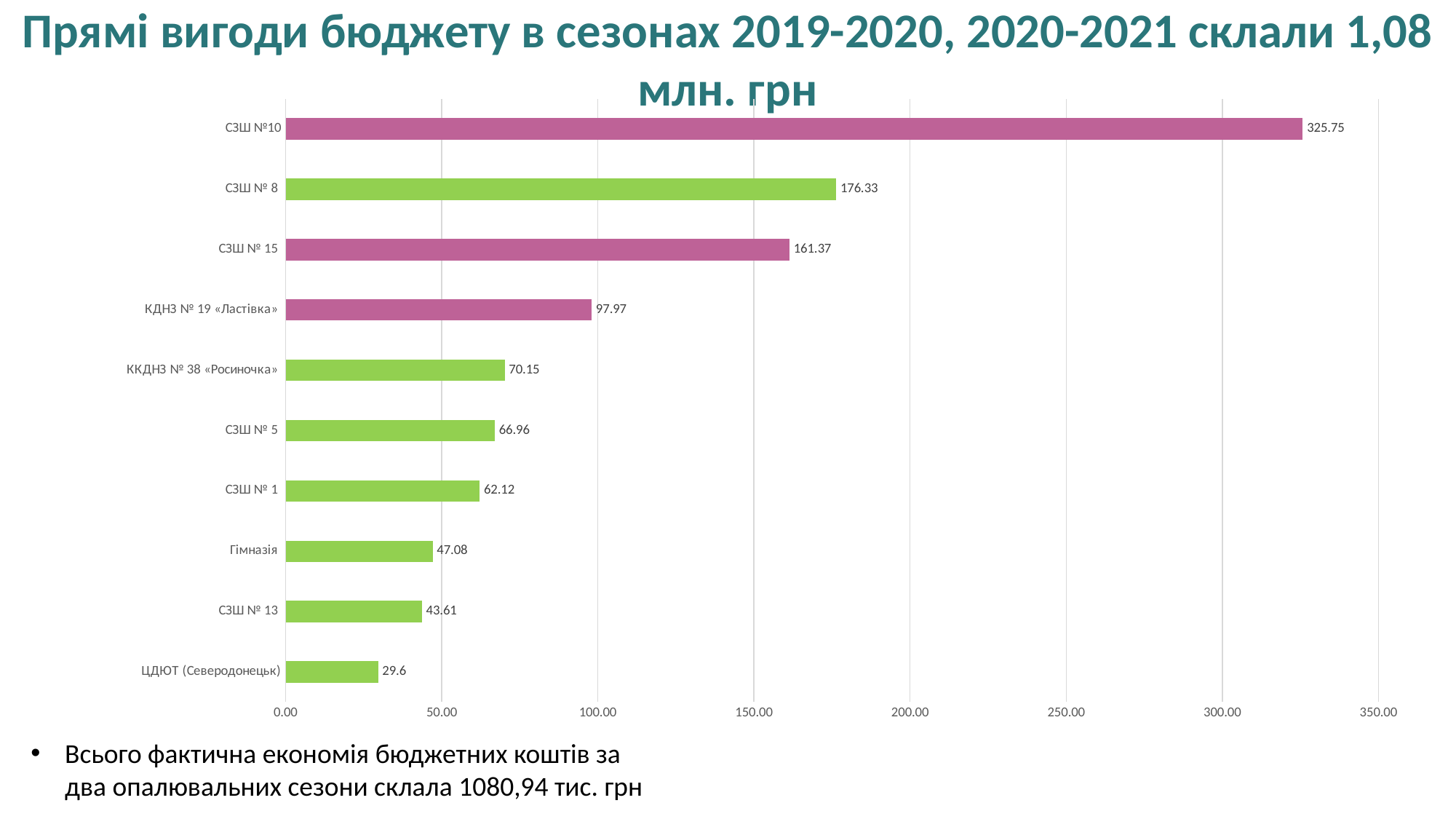
What is the difference between the values for СЗШ №10 and СЗШ № 8? 149.42 Which category has the highest value? СЗШ №10 Which category has the lowest value? ЦДЮТ (Северодонецьк) What colour is the bar for СЗШ № 15? Pink What is the value for КДНЗ № 19 «Ластівка»? 97.97 What kind of chart is shown on the slide? Bar chart What is the value for СЗШ №10? 325.75 What is the difference between the values for СЗШ № 8 and СЗШ № 15? 14.96 How many categories are shown in the chart? 10 What is the value for ЦДЮТ (Северодонецьк)? 29.6 Which has a larger value, СЗШ № 5 or СЗШ № 1? СЗШ № 5 What is the value for Гімназія? 47.08